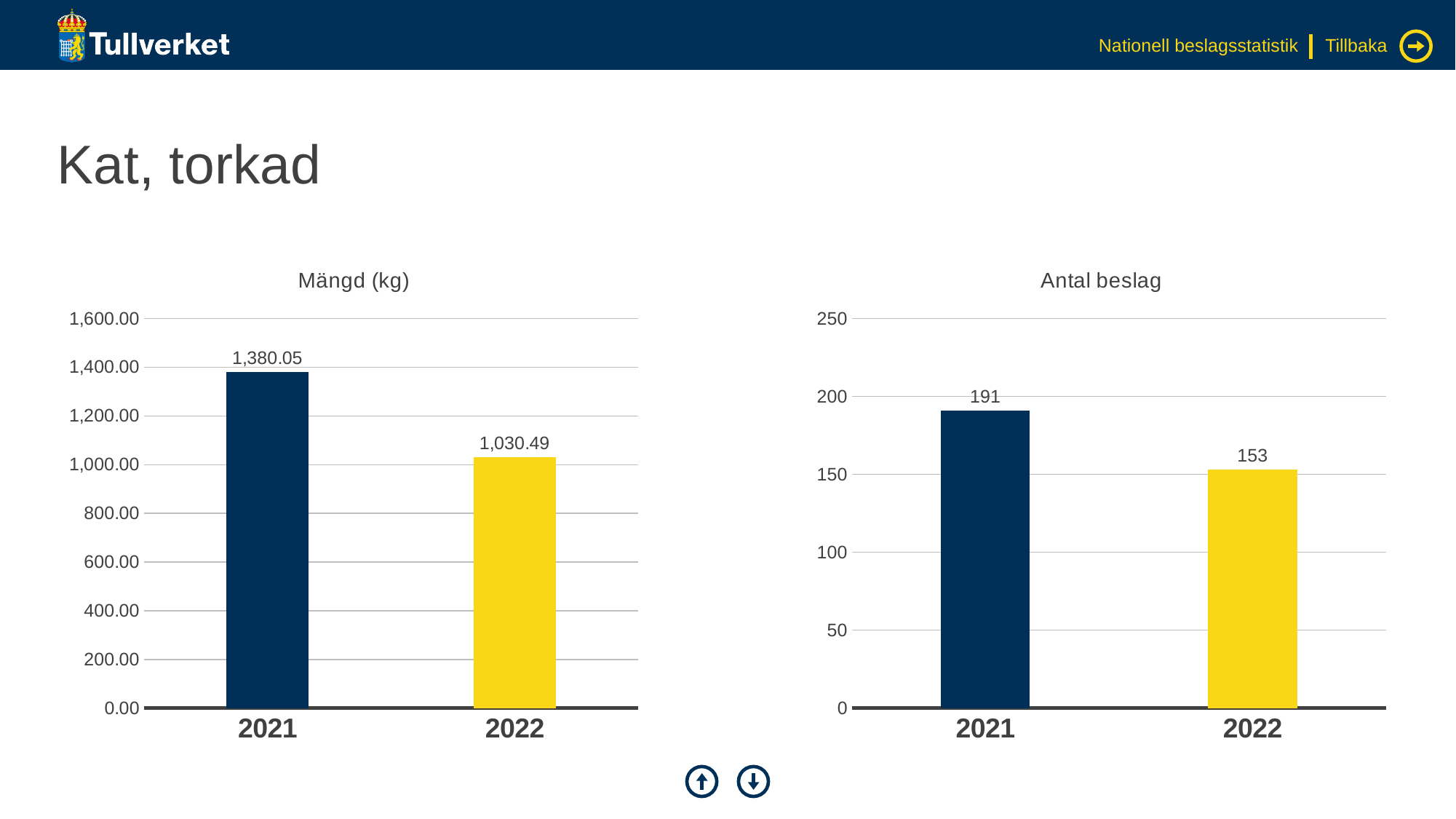
In the 'Antal beslag' chart, which year has the lowest value? 2022 In the 'Mängd (kg)' chart, what is the difference between the values for 2021 and 2022? 349.56 In the 'Antal beslag' chart, is the value for 2021 greater or less than 200? less How many categories are shown in the 'Mängd (kg)' chart? 2 In the 'Mängd (kg)' chart, which year has the highest value? 2021 In the 'Mängd (kg)' chart, what is the value for 2021? 1,380.05 What kind of chart is the 'Antal beslag' chart? bar chart In the 'Mängd (kg)' chart, what is the value for 2022? 1,030.49 In the 'Antal beslag' chart, what is the value for 2021? 191 In the 'Antal beslag' chart, what is the value for 2022? 153 In the 'Mängd (kg)' chart, do the values rise or fall from 2021 to 2022? fall In the 'Antal beslag' chart, what is the difference between the values for 2021 and 2022? 38